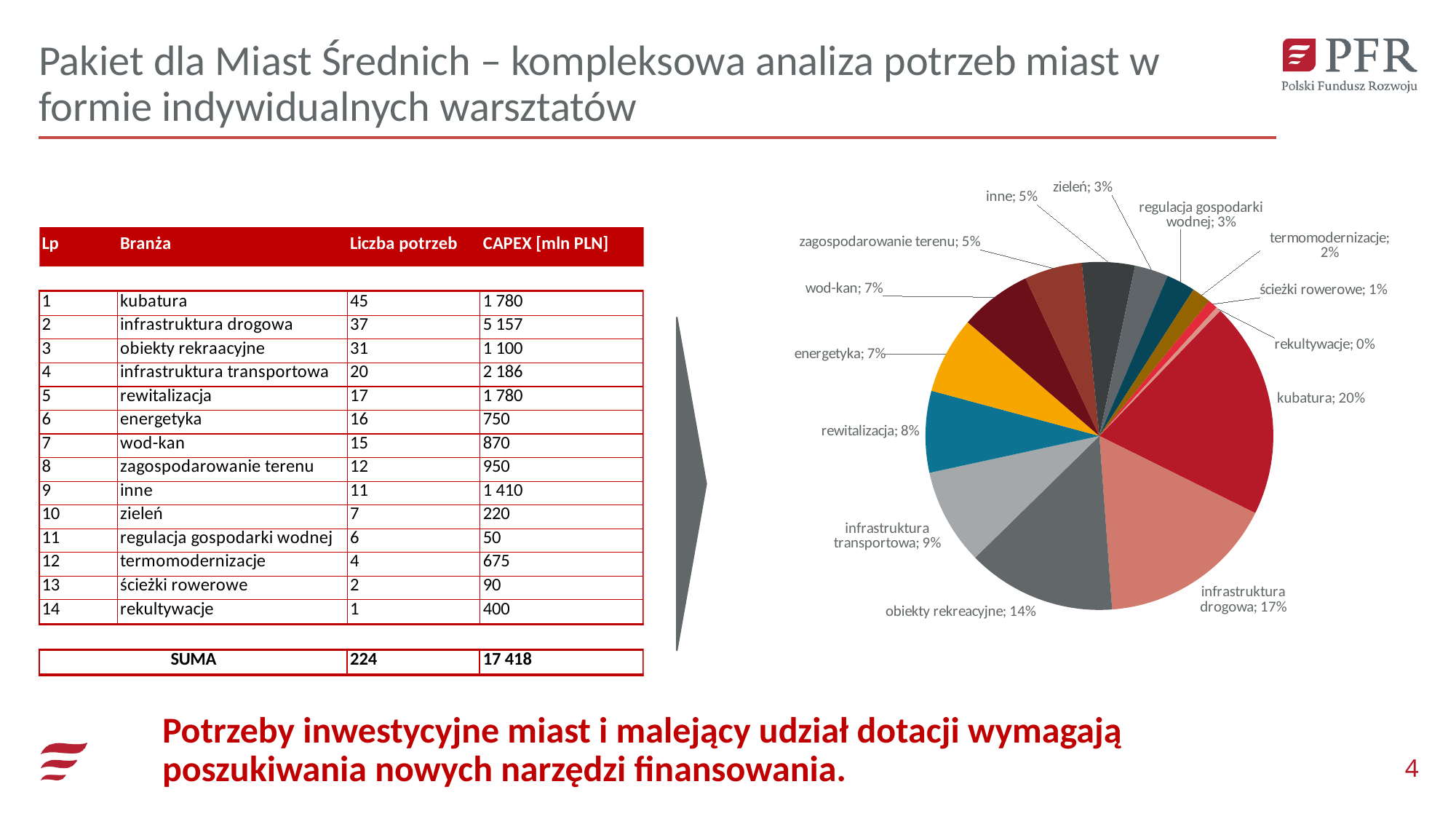
How many slices does the pie chart have? 14 What kind of chart is shown on the slide? pie chart What share of the pie chart does rewitalizacja have? 8% Which category has the smallest slice in the pie chart? rekultywacje Which category has the largest slice in the pie chart? kubatura What share of the pie chart does kubatura have? 20% What is the difference in percentage points between kubatura and infrastruktura drogowa in the pie chart? 3 What share of the pie chart does infrastruktura drogowa have? 17% Which slice is larger in the pie chart, infrastruktura transportowa or energetyka? infrastruktura transportowa What share of the pie chart does obiekty rekreacyjne have? 14% What share of the pie chart does termomodernizacje have? 2% What share of the pie chart does ścieżki rowerowe have? 1%